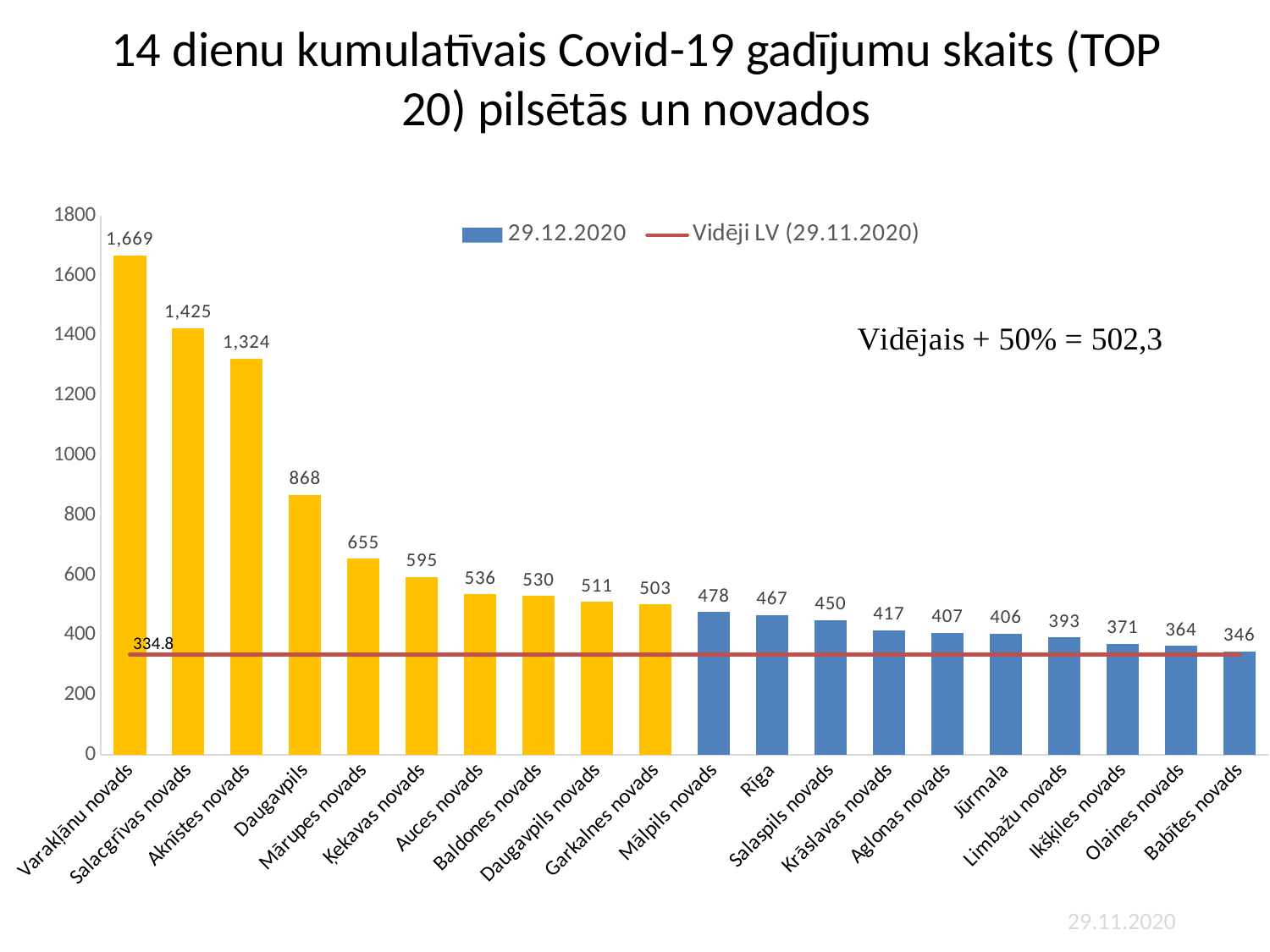
What is the value for Daugavpils? 868 Do the bar values rise or fall from left to right along the x axis? fall What is the value for Babītes novads? 346 Which category has the highest value? Varakļānu novads What is the value for Rīga? 467 How many categories are shown on the x axis? 20 Which is larger, the value for Mārupes novads or the value for Ķekavas novads? Mārupes novads How many entries does the legend list? 2 Which category has the lowest value? Babītes novads What value is labelled on the horizontal line for Vidēji LV (29.11.2020)? 334.8 What is the difference between the values for Varakļānu novads and Salacgrīvas novads? 244 What kind of chart is this? combination bar and line chart